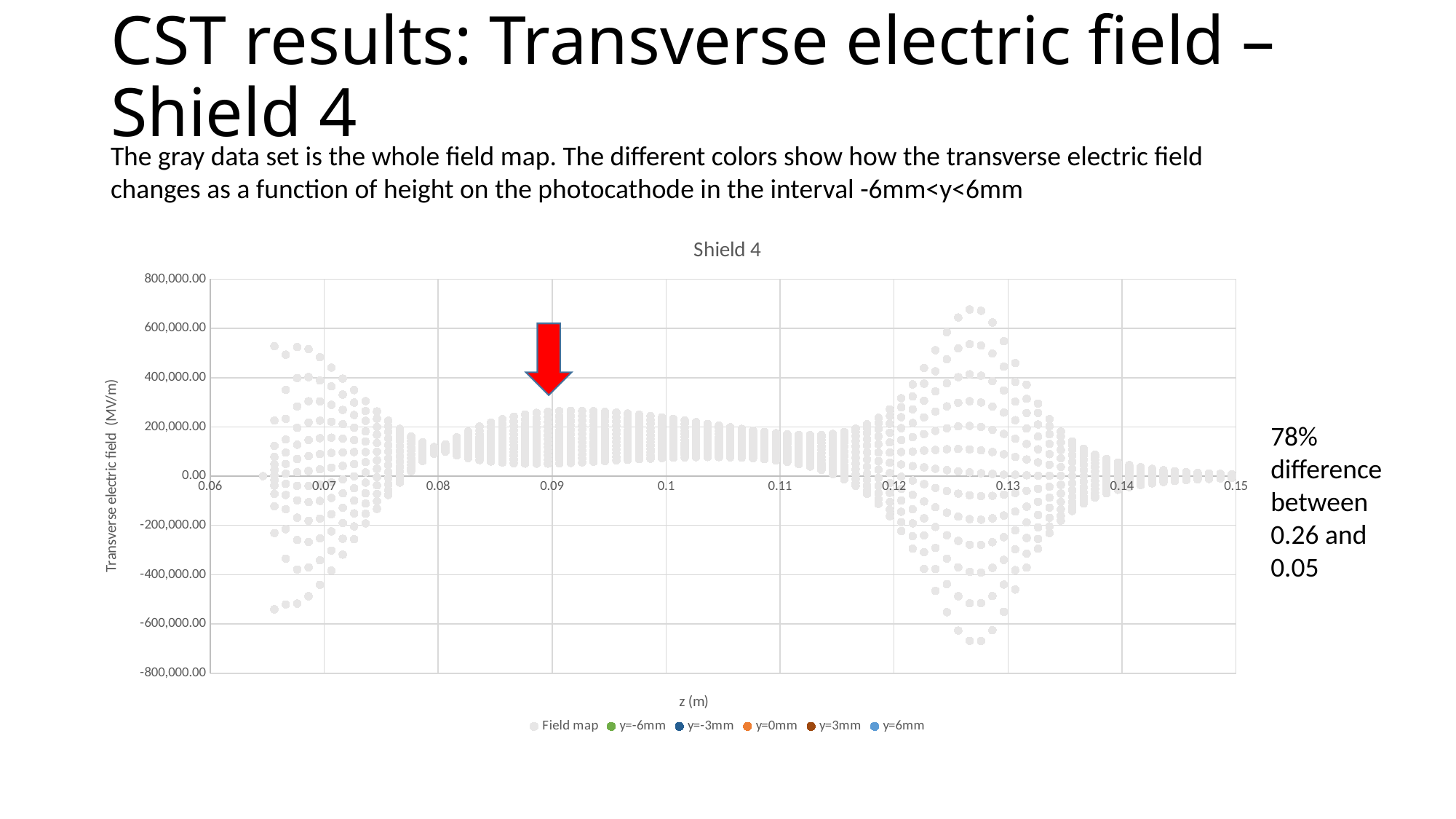
Is the highest Field map value near z = 0.07 greater or less than 400,000.00? greater Is the highest Field map value near z = 0.13 greater or less than 600,000.00? greater What is the label of the x axis of the chart? z (m) Which series in the legend is plotted in gray? Field map Is the highest Field map value near z = 0.145 greater or less than 200,000.00? less How many series does the legend of the Shield 4 chart list? 6 What is the title of the chart? Shield 4 What kind of chart is shown on the slide? scatter chart